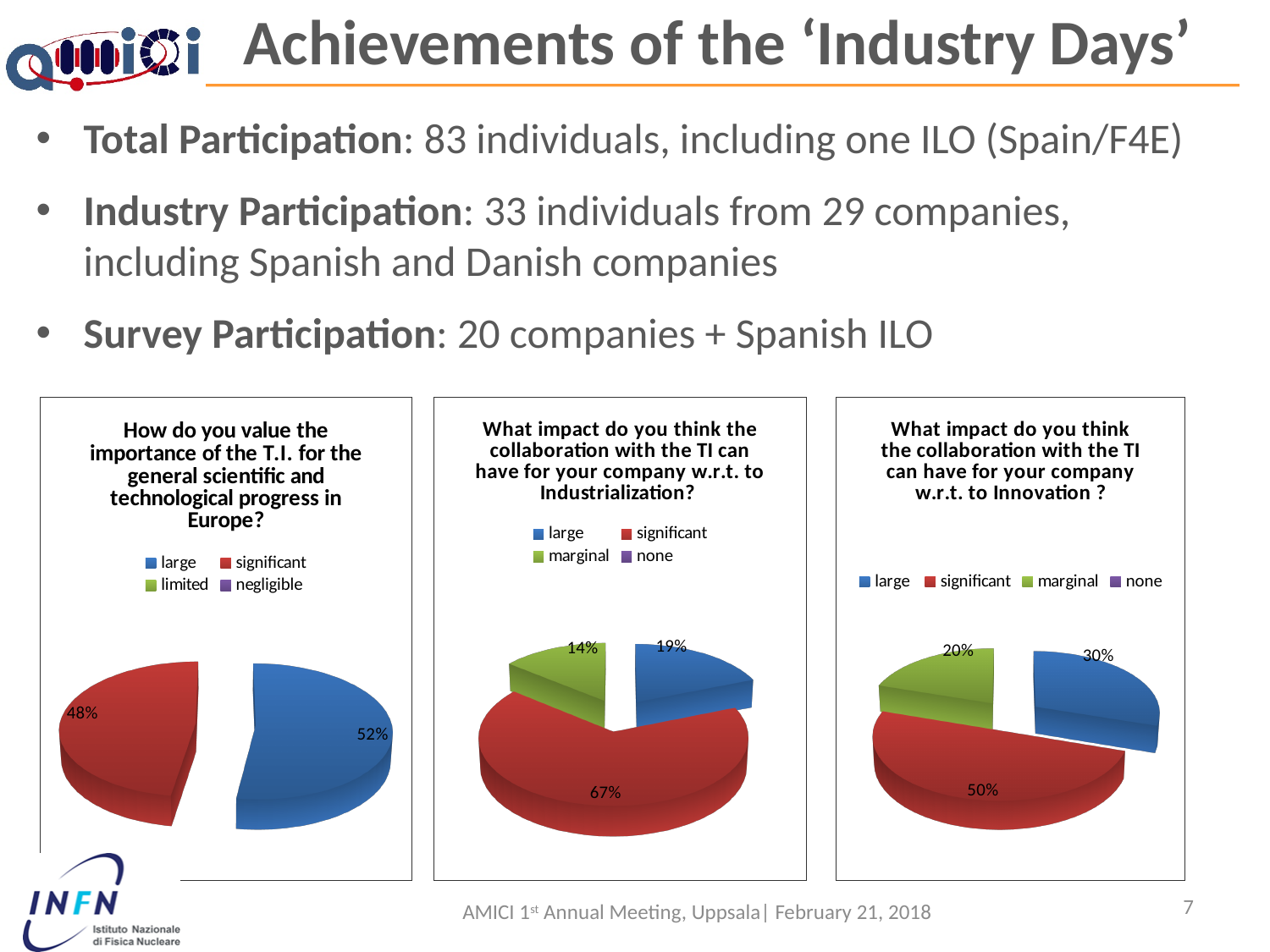
In the middle chart (impact w.r.t. Industrialization), what share of respondents answered 'significant'? 67% In the right chart (impact w.r.t. Innovation), which response has the largest share? significant In the right chart (impact w.r.t. Innovation), what share of respondents answered 'large'? 30% In the left chart ('How do you value the importance of the T.I. ...'), what share of respondents answered 'large'? 52% In the middle chart (impact w.r.t. Industrialization), which labelled response has the smallest share? marginal In the right chart (impact w.r.t. Innovation), what is the difference in percentage points between the 'large' and 'marginal' shares? 10 In the left chart ('How do you value the importance of the T.I. ...'), which is larger: the 'large' share or the 'significant' share? large In the left chart ('How do you value the importance of the T.I. ...'), what share of respondents answered 'significant'? 48% What type of chart is used in the middle chart (impact w.r.t. Industrialization)? pie chart In the middle chart (impact w.r.t. Industrialization), what share of respondents answered 'marginal'? 14% In the middle chart (impact w.r.t. Industrialization), what is the difference in percentage points between the 'significant' and 'large' shares? 48 How many entries does the legend of the right chart (impact w.r.t. Innovation) list? 4